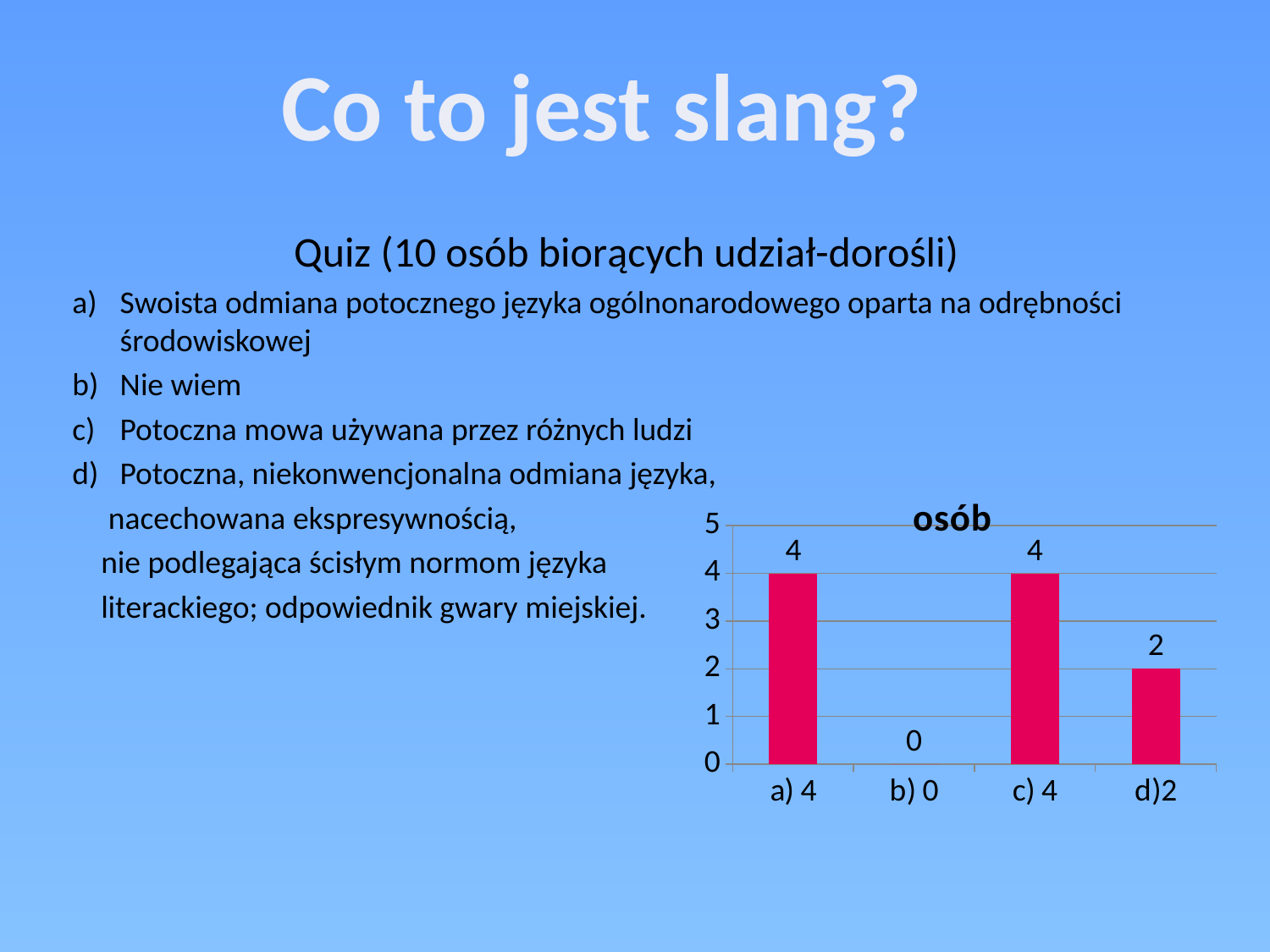
What kind of chart is shown on the slide? bar chart What is the title of the chart? osób How many categories are shown in the chart? 4 What is the value for category "d)2" in the chart? 2 What is the difference between the values for "c) 4" and "d)2"? 2 What is the value for category "b) 0" in the chart? 0 What is the total of all the values shown in the chart? 10 What is the value for category "a) 4" in the chart? 4 Which category has the lowest value in the chart? b) 0 Which is larger, the value for "a) 4" or the value for "d)2"? a) 4 Is the value for "d)2" greater or less than 3? less What is the highest value shown on the vertical axis of the chart? 5